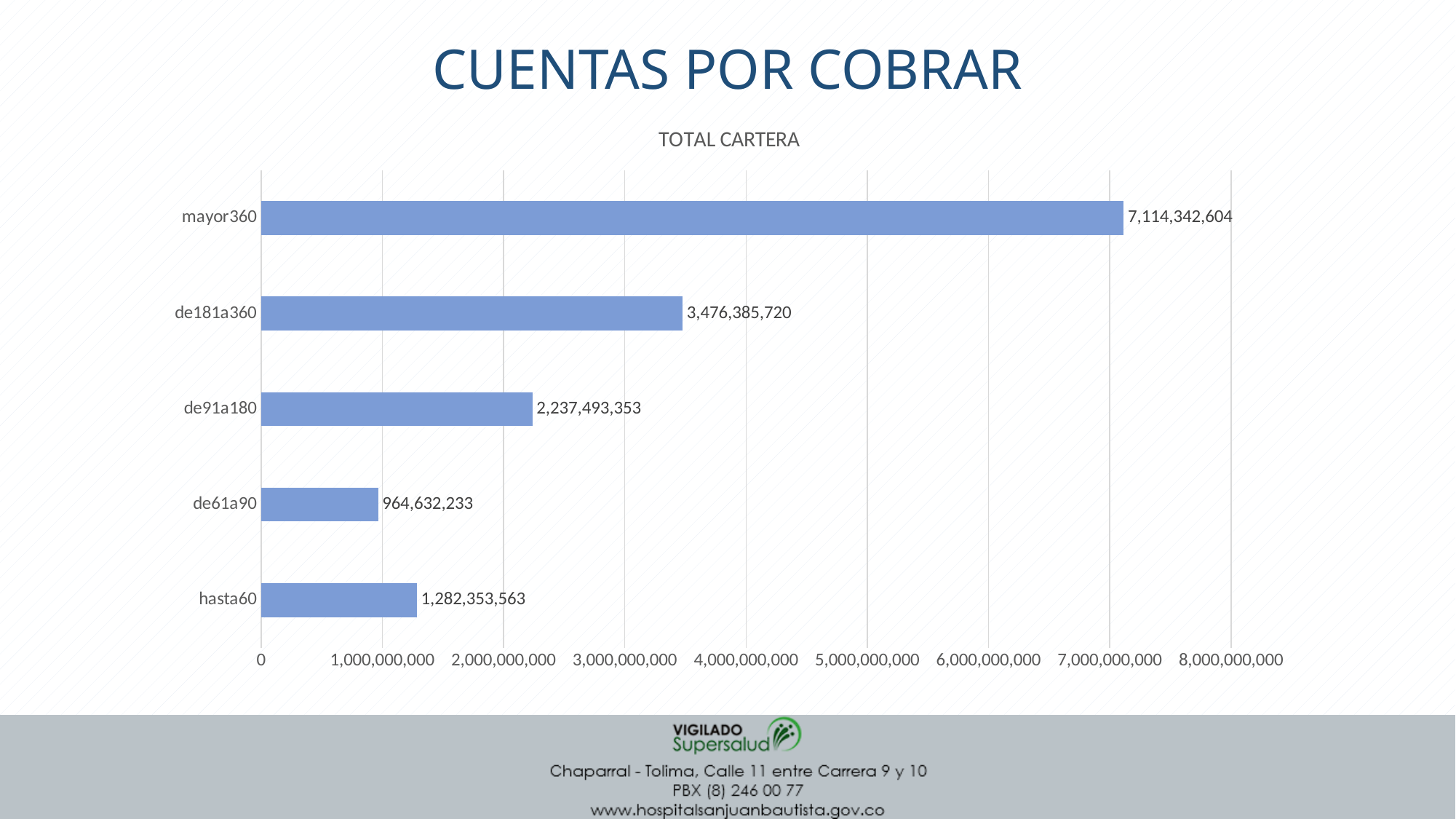
How many categories are shown in the chart? 5 Which category has the lowest value? de61a90 What is the value for de91a180? 2,237,493,353 Is the value for de91a180 greater or less than 2,000,000,000? greater What is the value for mayor360? 7,114,342,604 Which is larger, the value for hasta60 or the value for de61a90? hasta60 What type of chart is shown on the slide? bar chart What is the value for de181a360? 3,476,385,720 What is the value for hasta60? 1,282,353,563 What is the difference between the values for mayor360 and de181a360? 3,637,956,884 Which category has the highest value? mayor360 What is the difference between the values for hasta60 and de61a90? 317,721,330